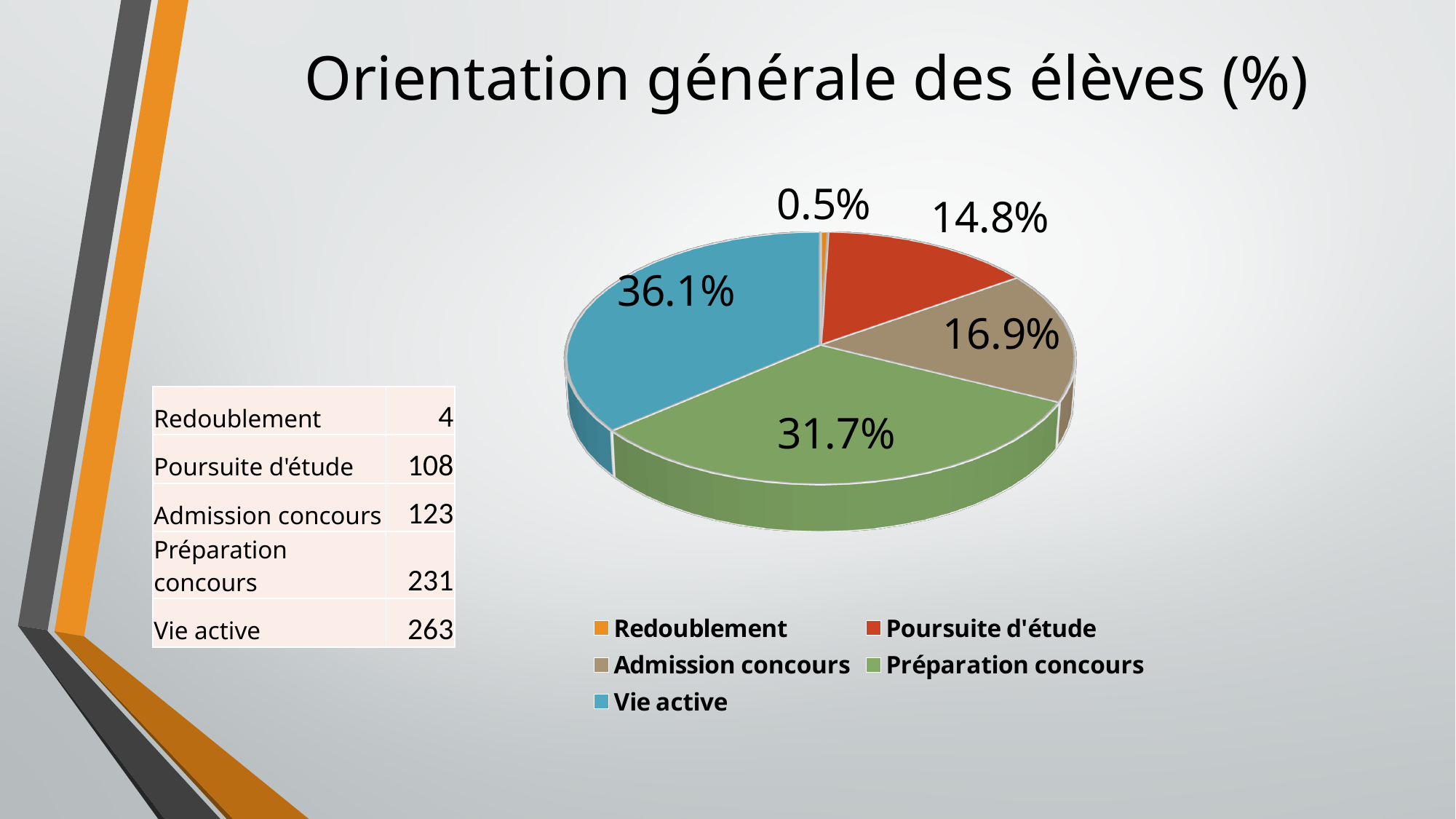
Which category has the smallest slice of the pie? Redoublement Which category has the largest slice of the pie? Vie active What percentage of the pie does Vie active represent? 36.1% What percentage of the pie does Redoublement represent? 0.5% What percentage of the pie does Poursuite d'étude represent? 14.8% What type of chart is shown on the slide? pie chart What percentage of the pie does Admission concours represent? 16.9% Which is larger, the slice for Admission concours or the slice for Poursuite d'étude? Admission concours What colour is the Vie active slice in the pie chart? blue What percentage of the pie does Préparation concours represent? 31.7% How many categories does the legend list? 5 What is the difference in percentage points between Vie active and Préparation concours? 4.4